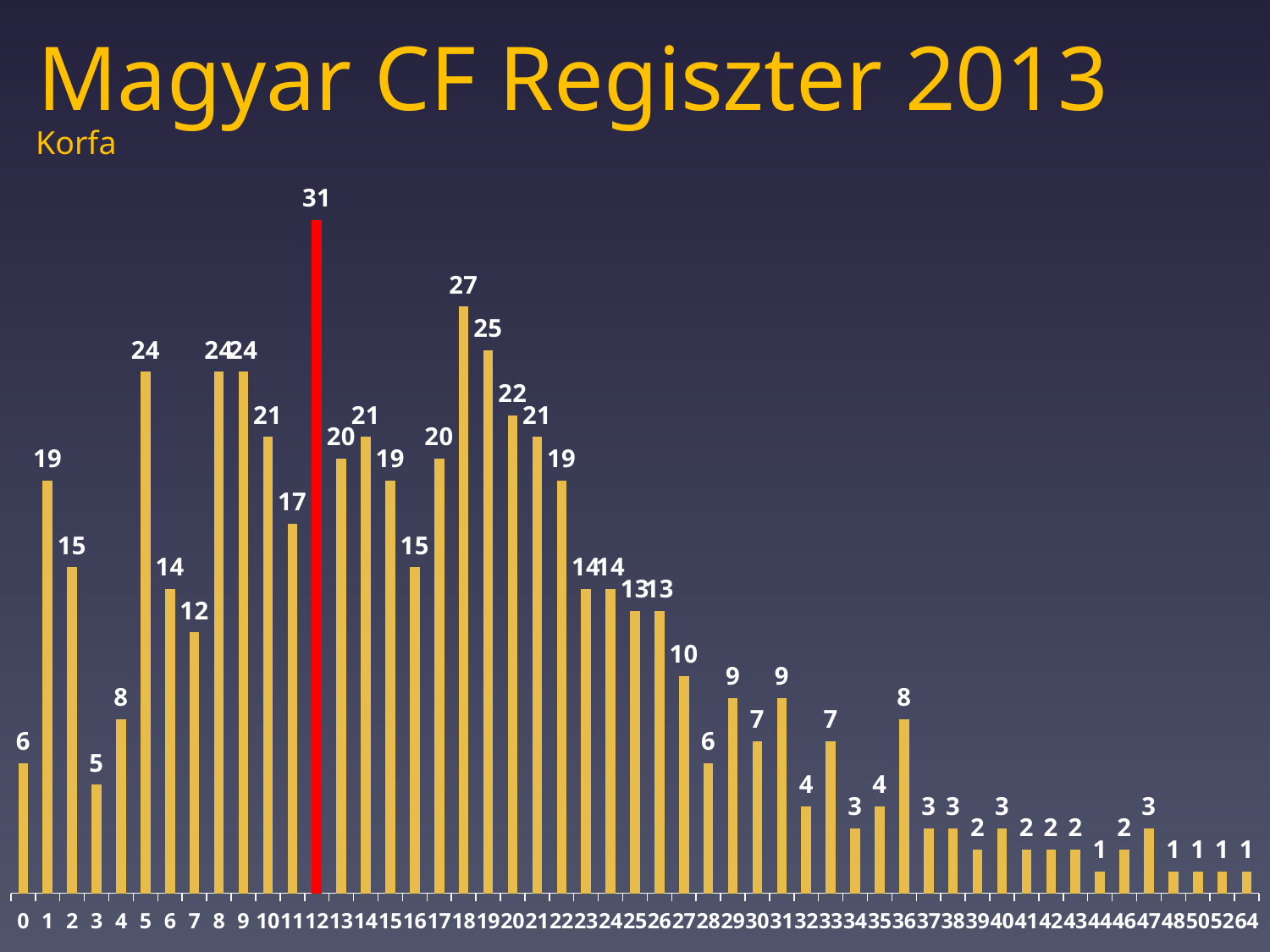
Which age's bar is coloured red? 12 Which has the larger value, age 1 or age 2? age 1 Which age has the highest value? 12 Which has the larger value, age 5 or age 10? age 5 What is the value for age 0? 6 What is the value for age 12? 31 What is the value for age 18? 27 What is the title of the chart? Magyar CF Regiszter 2013 What is the difference between the values for age 12 and age 18? 4 What is the value for age 36? 8 What kind of chart is shown on the slide? bar chart What is the difference between the values for age 19 and age 20? 3